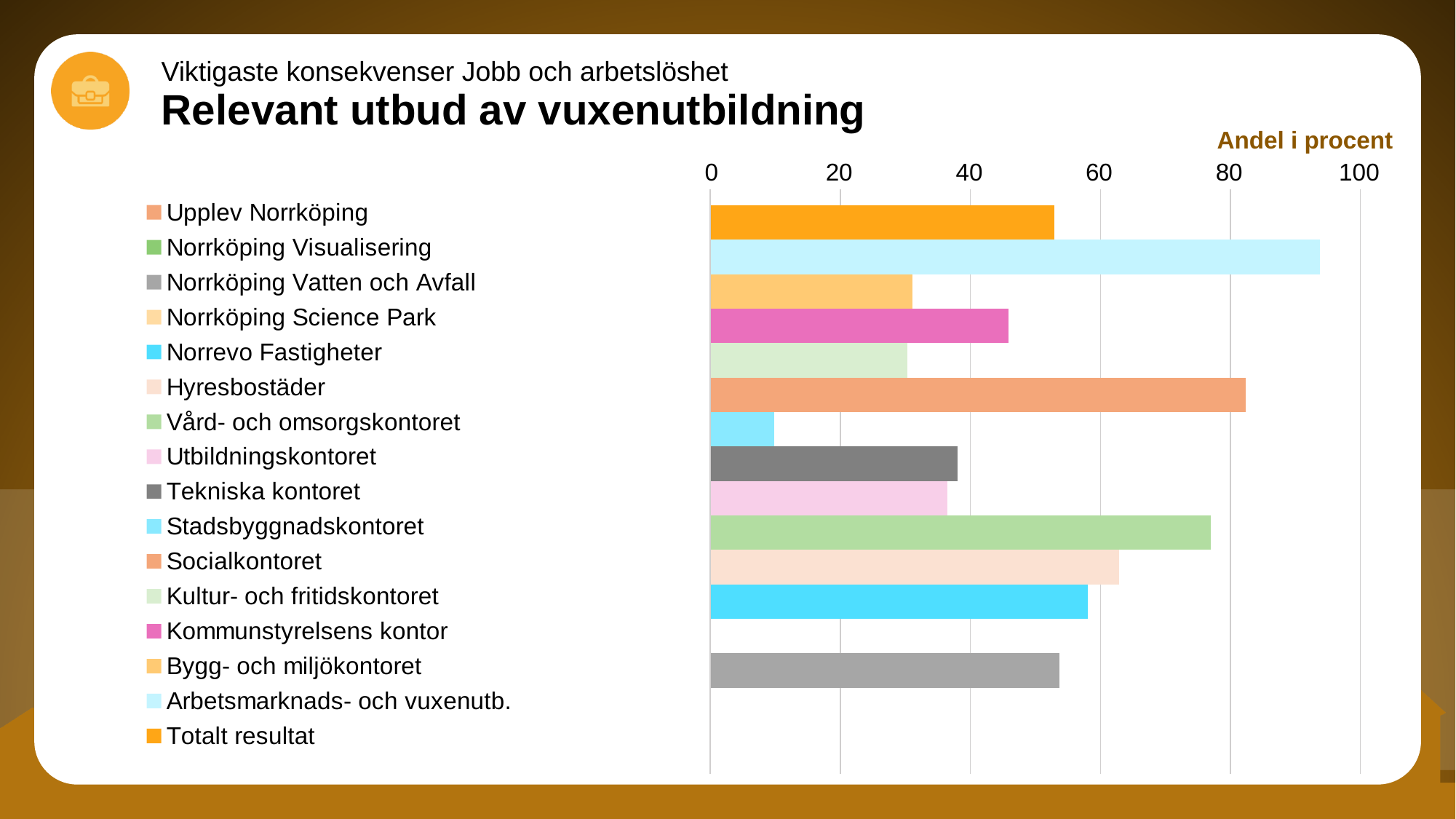
Which is larger, the value for Socialkontoret or the value for Totalt resultat? Socialkontoret Is the value for Stadsbyggnadskontoret greater or less than 20? less Is the value for Vård- och omsorgskontoret greater or less than 60? greater What kind of chart is shown on the slide? bar chart Is the value for Bygg- och miljökontoret greater or less than 40? less What label is shown above the horizontal axis of the chart? Andel i procent Which category has the longest bar in the chart? Arbetsmarknads- och vuxenutb. What is the highest value shown on the horizontal axis? 100 How many entries does the legend list? 16